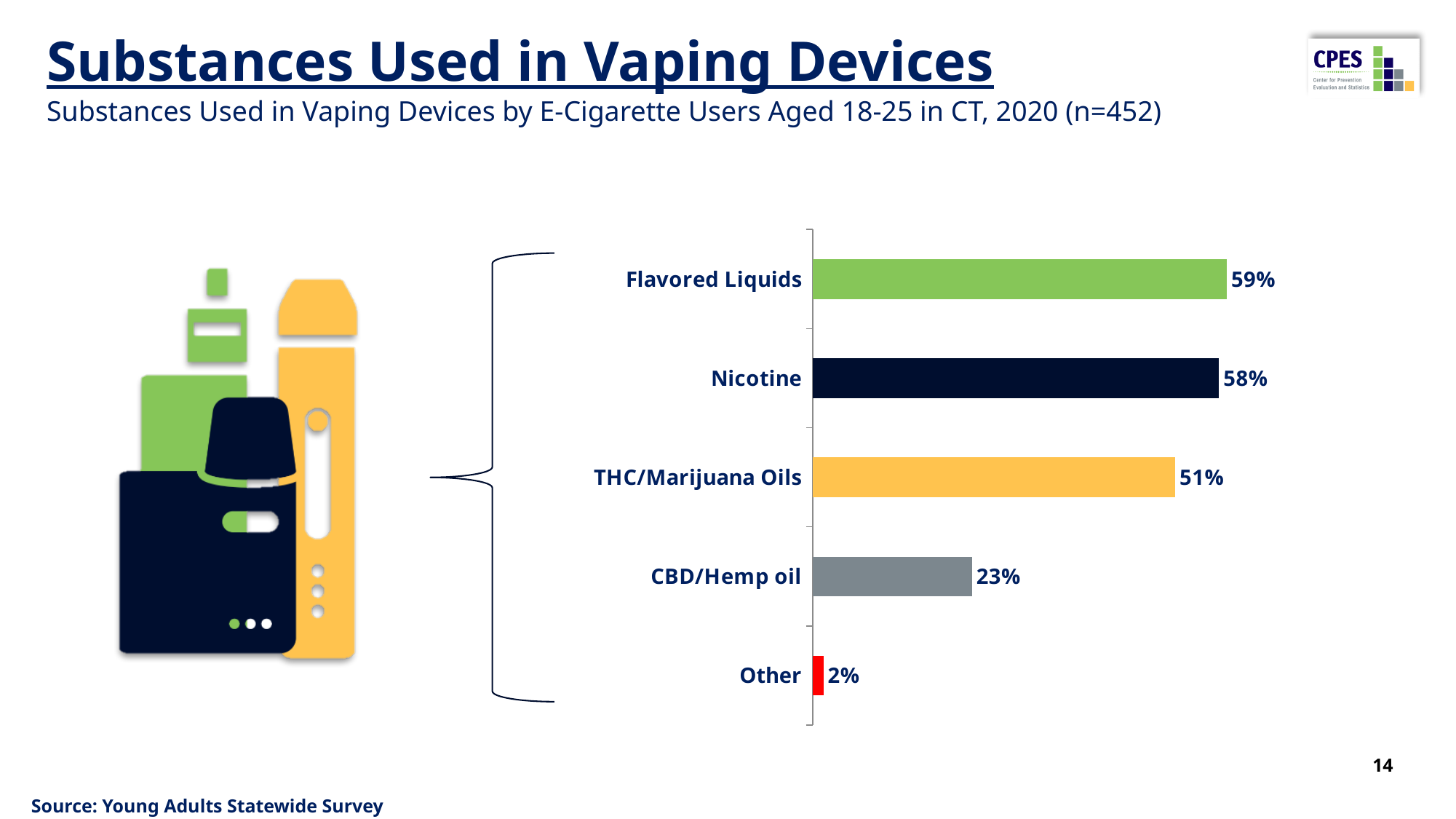
Which is larger, the value for Nicotine or the value for CBD/Hemp oil? Nicotine Which substance has the highest percentage of use? Flavored Liquids What percentage is shown for THC/Marijuana Oils? 51% Which substance has the lowest percentage of use? Other What is the difference in percentage points between THC/Marijuana Oils and CBD/Hemp oil? 28 What type of chart is used on this slide? Bar chart What is the value shown for Nicotine? 58% What percentage is shown for the Other category? 2% What percentage of e-cigarette users aged 18-25 reported using Flavored Liquids in their vaping devices? 59% How many substance categories are shown in the chart? 5 What is the value for CBD/Hemp oil? 23% What colour is the bar for the Other category? Red